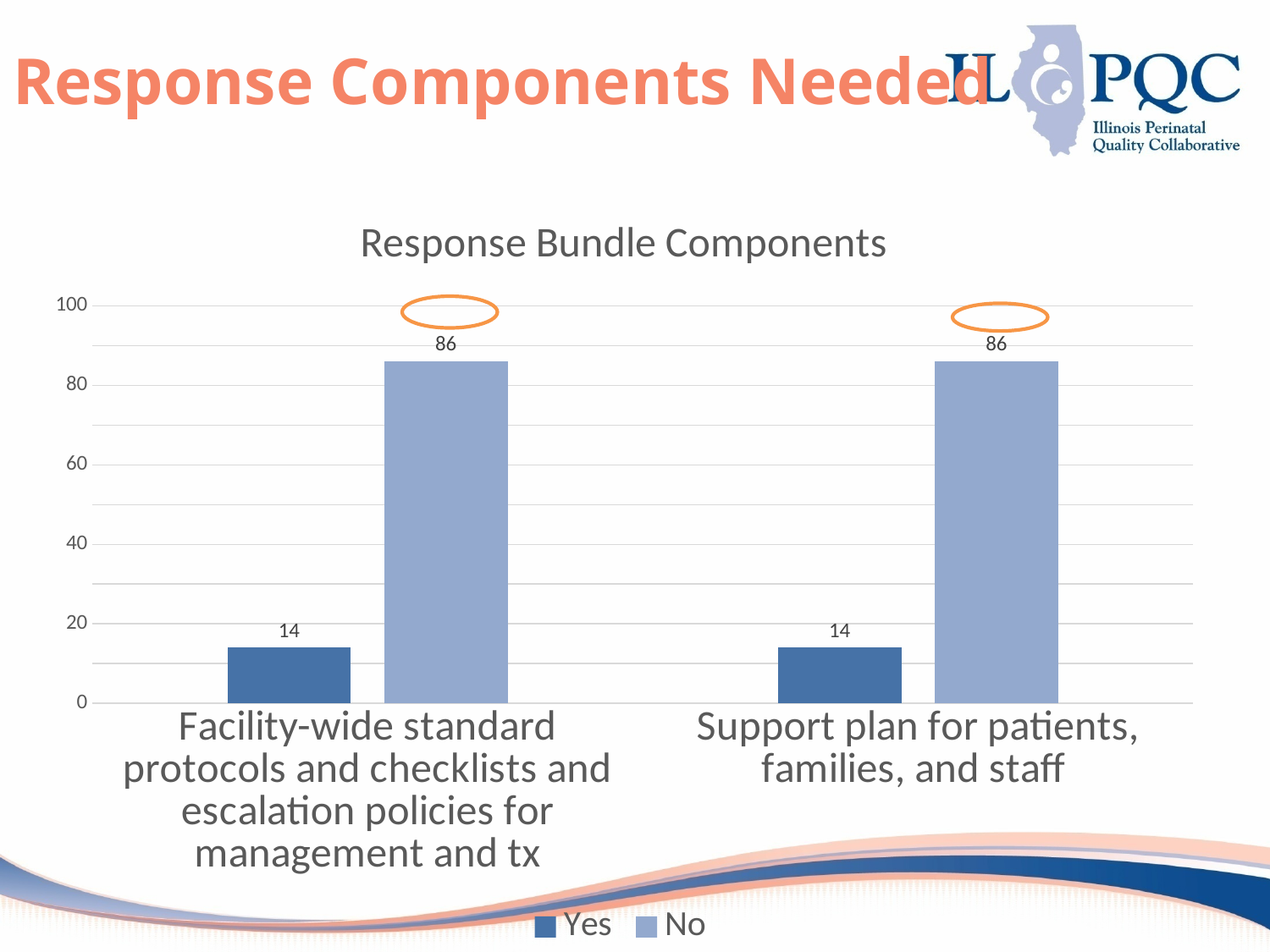
What is the title of the chart? Response Bundle Components What is the value of Yes for 'Facility-wide standard protocols and checklists and escalation policies for management and tx'? 14 Which series has the larger value for 'Facility-wide standard protocols and checklists and escalation policies for management and tx', Yes or No? No How many categories are shown on the x axis? 2 Is the Yes value for 'Support plan for patients, families, and staff' greater or less than 20? less What is the value of No for 'Support plan for patients, families, and staff'? 86 What is the value of Yes for 'Support plan for patients, families, and staff'? 14 How many series does the legend list? 2 What type of chart is shown on the slide? bar chart What is the difference between the No and Yes values for 'Support plan for patients, families, and staff'? 72 What is the value of No for 'Facility-wide standard protocols and checklists and escalation policies for management and tx'? 86 What are the two legend entries? Yes and No